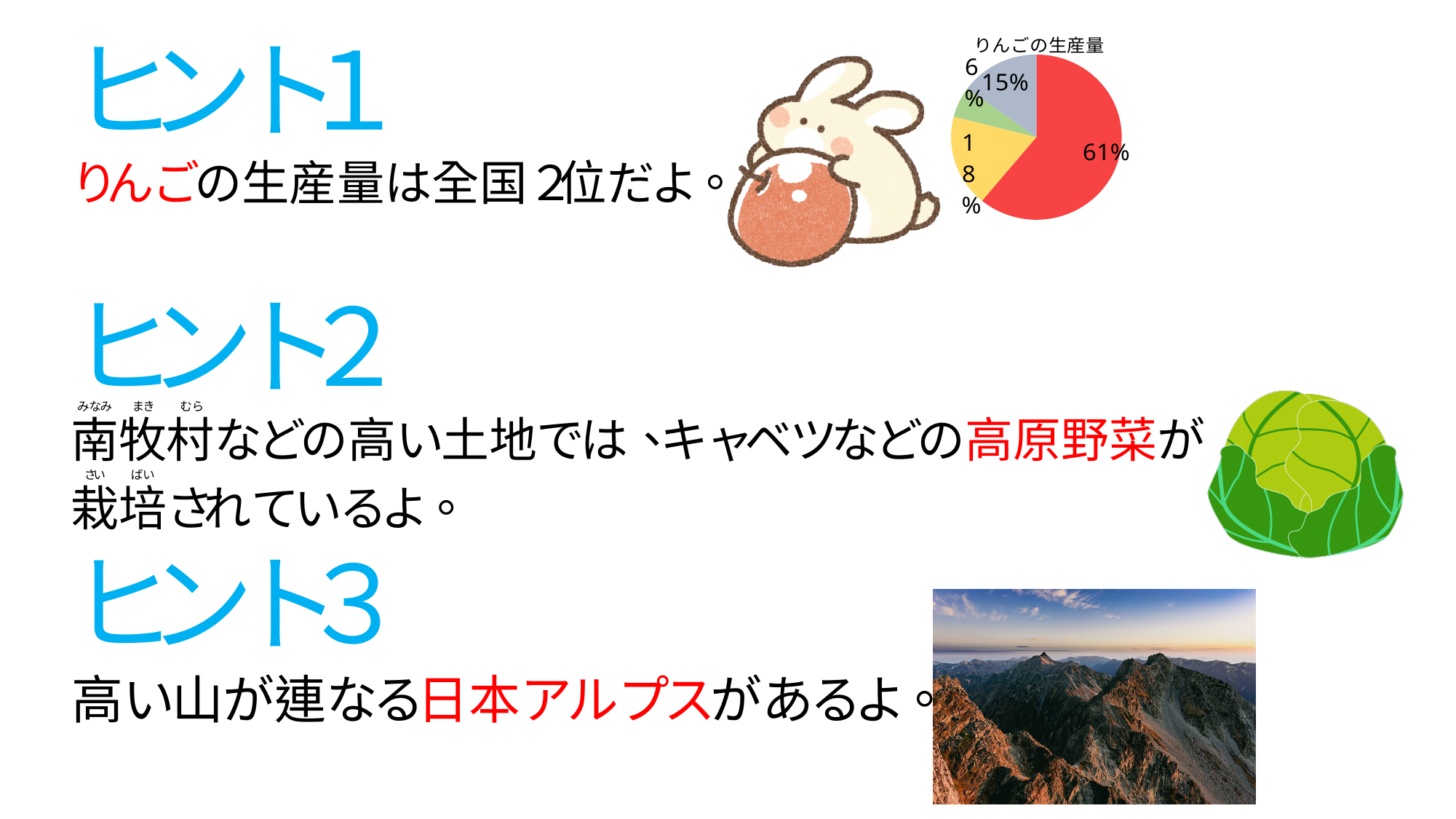
What percentage is shown for the grey slice of the pie chart? 15% What is the largest share shown in the pie chart? 61% What kind of chart is shown on the slide? pie chart How many slices does the pie chart have? 4 What percentage is shown for the green slice of the pie chart? 6% Which slice is larger, the yellow slice or the grey slice? yellow slice What percentage is shown for the red slice of the pie chart? 61% What is the difference in percentage points between the largest slice (61%) and the 18% slice? 43 What is the smallest share shown in the pie chart? 6% What percentage is shown for the yellow slice of the pie chart? 18% Is the largest slice of the pie chart greater or less than 50%? greater What is the title of the pie chart? りんごの生産量